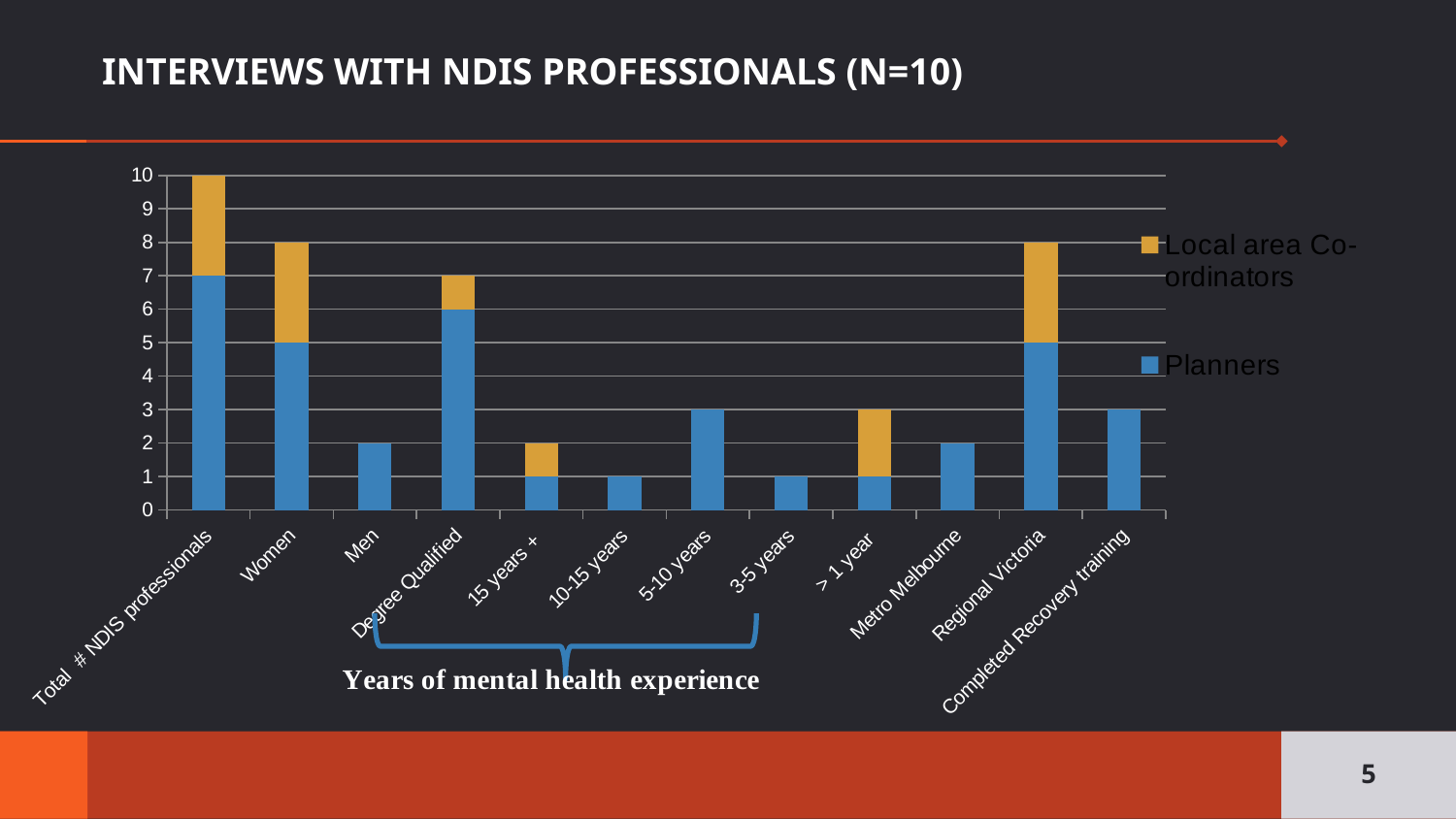
What is the Planners value for Degree Qualified? 6 Which category has the highest total stacked bar? Total # NDIS professionals What is the total height of the stacked bar for Regional Victoria? 8 What is the title of the slide containing the chart? INTERVIEWS WITH NDIS PROFESSIONALS (N=10) How many categories are shown on the x axis? 12 What is the Planners value for Total # NDIS professionals? 7 What is the total height of the stacked bar for Women? 8 Which is larger, the Planners value for 5-10 years or the Planners value for 3-5 years? 5-10 years What is the Planners value for Men? 2 What is the difference between the Planners value for Women and the Planners value for Men? 3 How many series does the legend list? 2 What kind of chart is shown on the slide? Stacked bar chart